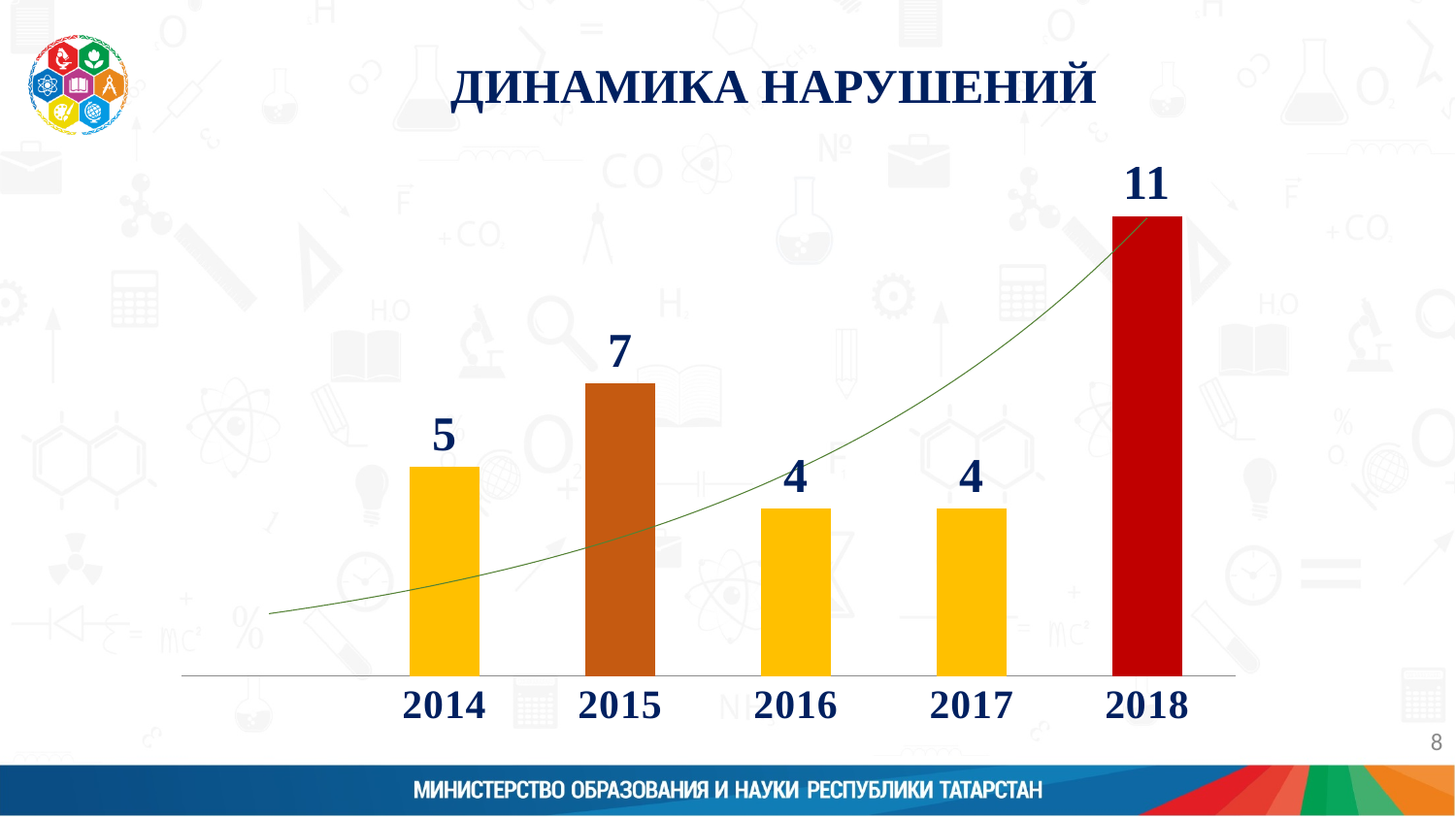
What is the value for 2015? 7 What is the title of the chart? ДИНАМИКА НАРУШЕНИЙ Which year has the highest value? 2018 What is the difference between the values for 2015 and 2014? 2 Which is larger, the value for 2014 or the value for 2017? 2014 What is the difference between the values for 2018 and 2015? 4 What is the value for 2016? 4 Do the values rise or fall from 2017 to 2018? rise What kind of chart is shown on the slide? bar chart What is the value for 2018? 11 What is the value for 2014? 5 How many years are shown on the x axis? 5